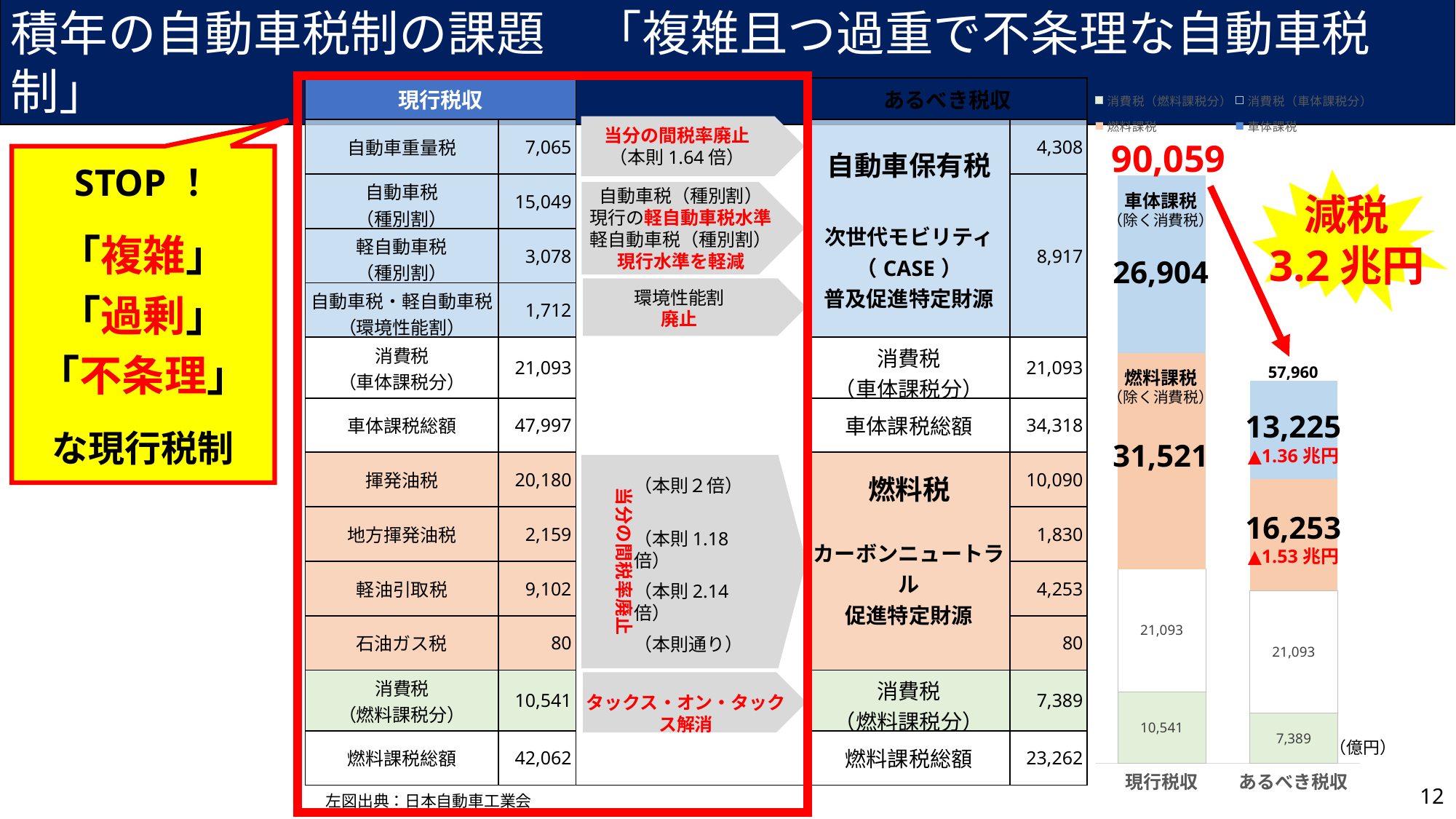
In the bar chart on the right, what is the 車体課税 value for 現行税収? 26,904 In the bar chart on the right, what is the 消費税（車体課税分） value for あるべき税収? 21,093 How many series does the legend of the bar chart on the right list? 4 In the bar chart on the right, what is the difference between the 燃料課税 values for 現行税収 and あるべき税収? 15,268 In the bar chart on the right, what is the total of the 現行税収 bar? 90,059 In the bar chart on the right, what is the total of the あるべき税収 bar? 57,960 What kind of chart is shown on the right side of the slide? stacked bar chart In the bar chart on the right, which bar has the larger total, 現行税収 or あるべき税収? 現行税収 In the bar chart on the right, what is the 消費税（燃料課税分） value for 現行税収? 10,541 In the bar chart on the right, what is the 燃料課税 value for あるべき税収? 16,253 How many bars are plotted in the bar chart on the right? 2 In the bar chart on the right, which segment of the 現行税収 bar is the largest? 燃料課税